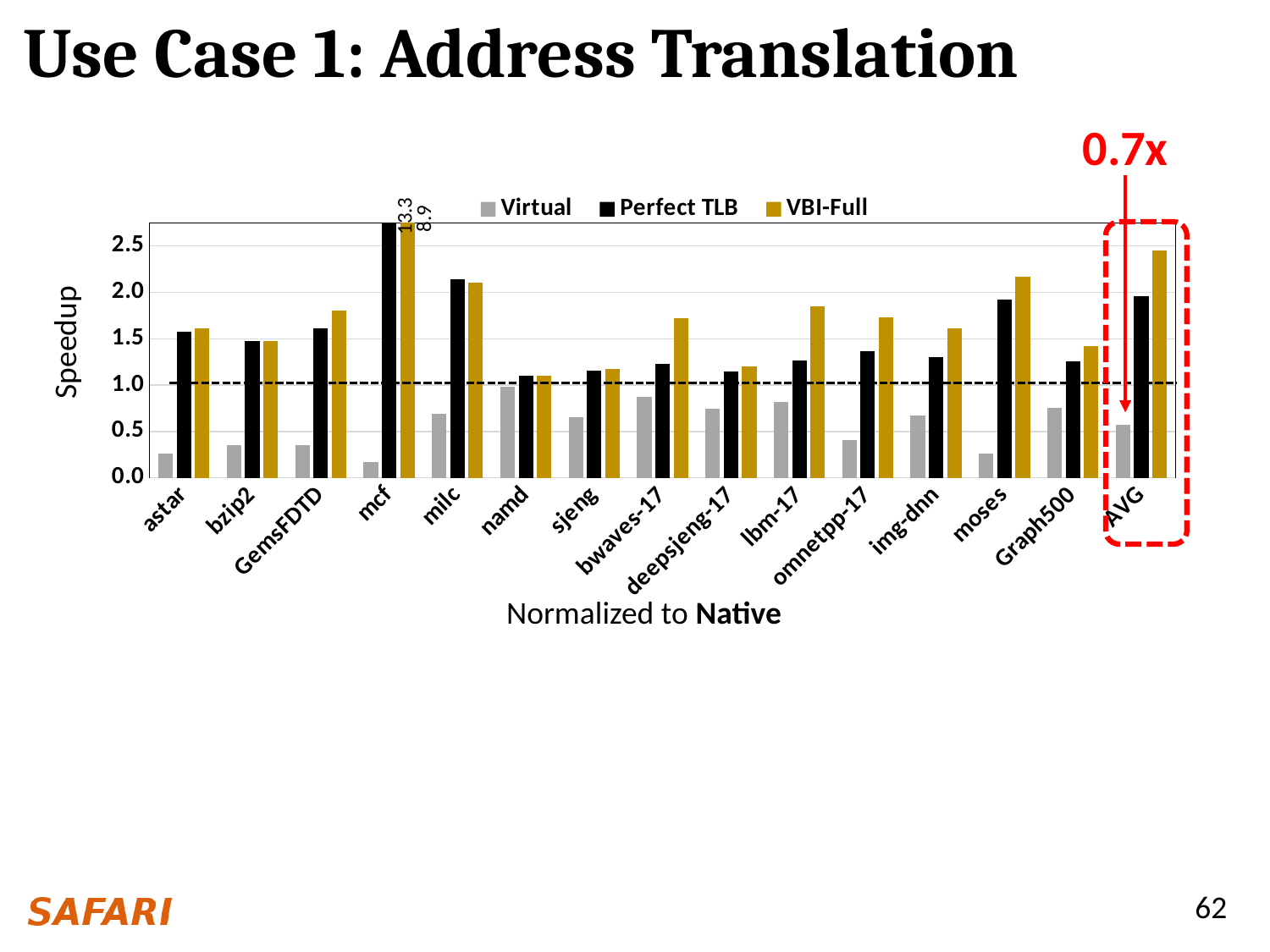
What is the Perfect TLB speedup for mcf? 8.9 How many series does the legend list? 3 What is the difference between the Perfect TLB and VBI-Full speedups for mcf? 4.4 Is the Virtual speedup for astar greater or less than 0.5? less Is the VBI-Full speedup for moses greater or less than 2.0? greater What kind of chart is shown on the slide? bar chart What is the VBI-Full speedup for mcf? 13.3 What value does the red annotation above the AVG group show? 0.7x Which category has the highest Perfect TLB speedup? mcf For bwaves-17, which is larger: the Perfect TLB speedup or the VBI-Full speedup? VBI-Full What is the label on the y axis? Speedup How many categories are shown along the x axis? 15